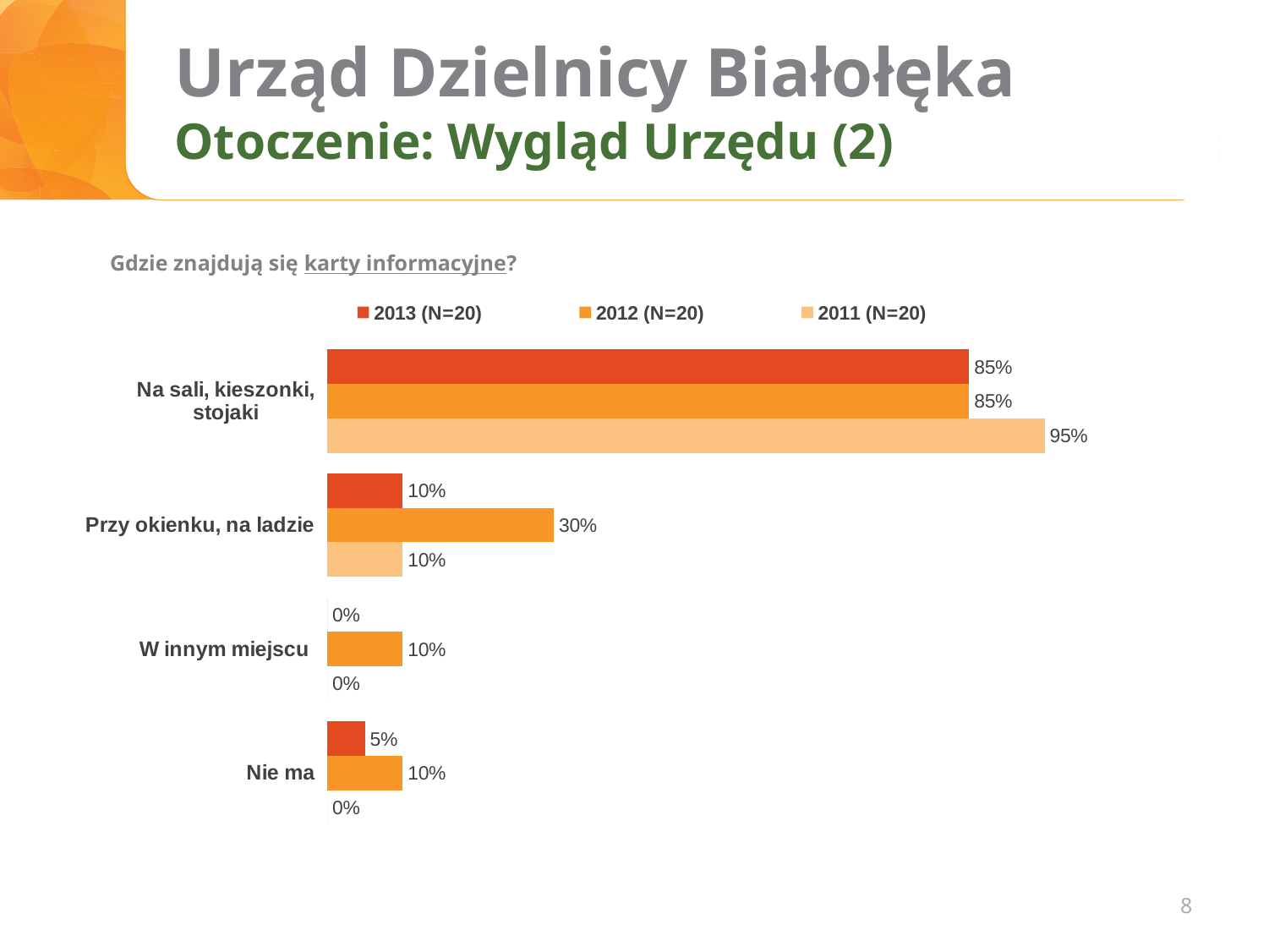
How many categories are shown on the chart? 4 How many series does the legend list? 3 What kind of chart is shown on the slide? Bar chart What question does the chart answer, as stated above it? Gdzie znajdują się karty informacyjne? Which category has the highest value in the 2011 (N=20) series? Na sali, kieszonki, stojaki What is the value for 'Nie ma' in the 2013 (N=20) series? 5% What is the value for 'Przy okienku, na ladzie' in the 2012 (N=20) series? 30% What is the value for 'W innym miejscu' in the 2011 (N=20) series? 0% What is the difference between the 2011 (N=20) and 2013 (N=20) values for 'Na sali, kieszonki, stojaki'? 10% Which category has the lowest value in the 2013 (N=20) series? W innym miejscu What is the value for 'Na sali, kieszonki, stojaki' in the 2013 (N=20) series? 85% Which is larger for 'Przy okienku, na ladzie': the 2012 (N=20) value or the 2013 (N=20) value? 2012 (N=20)